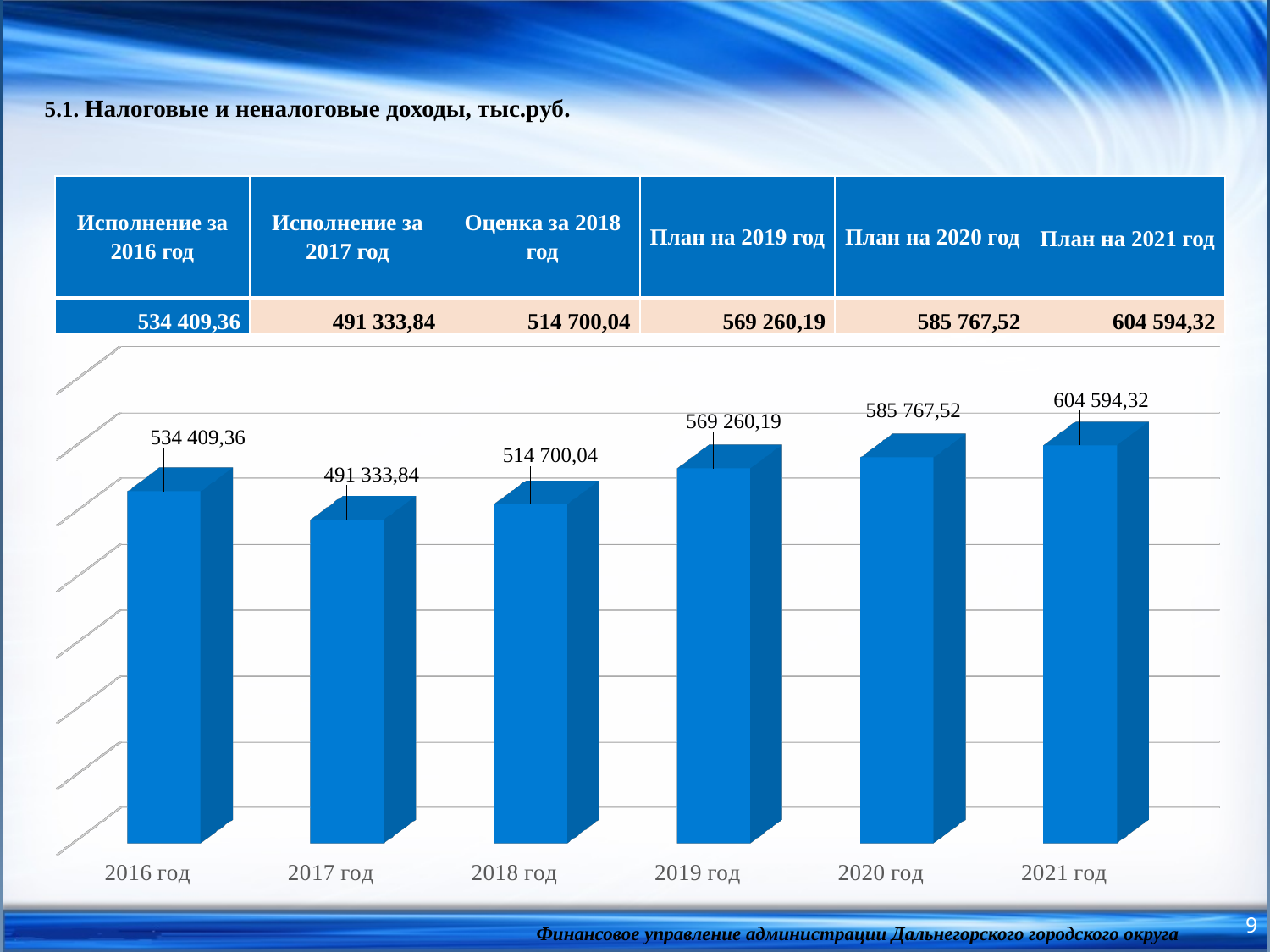
From 2017 год to 2021 год, do the values rise or fall? Rise Which year has the highest value in the chart? 2021 год What is the value for 2017 год in the chart? 491 333,84 What is the value for 2021 год in the chart? 604 594,32 What is the value for 2019 год in the chart? 569 260,19 How many years (categories) are shown in the chart? 6 What kind of chart is shown on the slide? Bar chart Which is larger, the value for 2016 год or the value for 2018 год? 2016 год What is the title of the slide above the chart? 5.1. Налоговые и неналоговые доходы, тыс.руб. What is the difference between the values for 2021 год and 2016 год? 70 184,96 Which year has the lowest value in the chart? 2017 год What is the difference between the values for 2020 год and 2019 год? 16 507,33